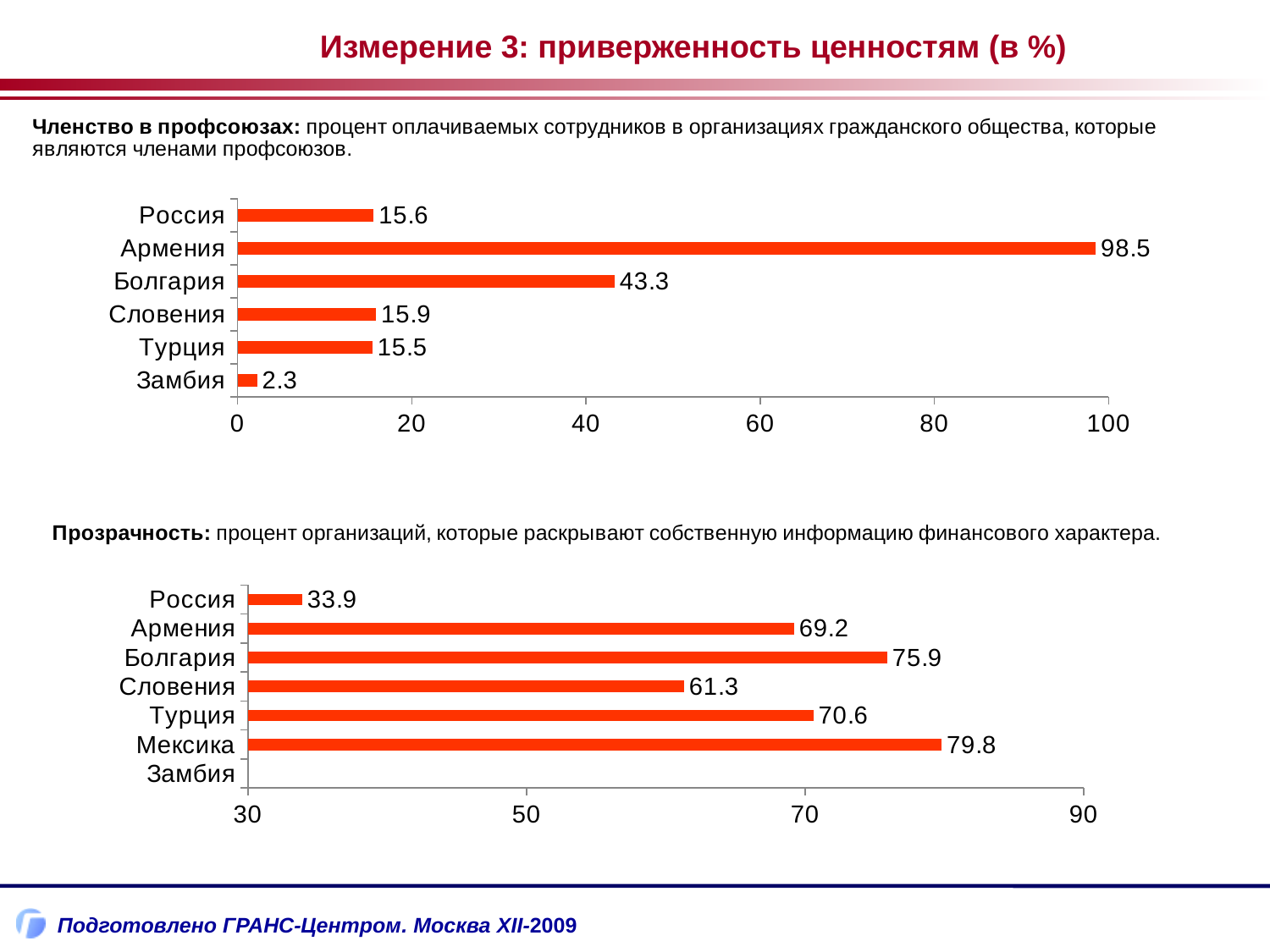
In the bottom chart (Прозрачность), what is the difference between the values for Мексика and Россия? 45.9 In the top chart (Членство в профсоюзах), what is the value for Болгария? 43.3 In the bottom chart (Прозрачность), what is the value for Мексика? 79.8 In the top chart (Членство в профсоюзах), what is the difference between the values for Армения and Болгария? 55.2 In the top chart (Членство в профсоюзах), which country has the lowest value? Замбия In the top chart (Членство в профсоюзах), which country has the highest value? Армения In the bottom chart (Прозрачность), which is larger, the value for Болгария or the value for Турция? Болгария In the top chart (Членство в профсоюзах), how many countries are shown? 6 In the bottom chart (Прозрачность), what is the value for Россия? 33.9 In the top chart (Членство в профсоюзах), what is the value for Армения? 98.5 What type of chart is the top chart (Членство в профсоюзах)? Bar chart In the bottom chart (Прозрачность), which country with a plotted bar has the highest value? Мексика